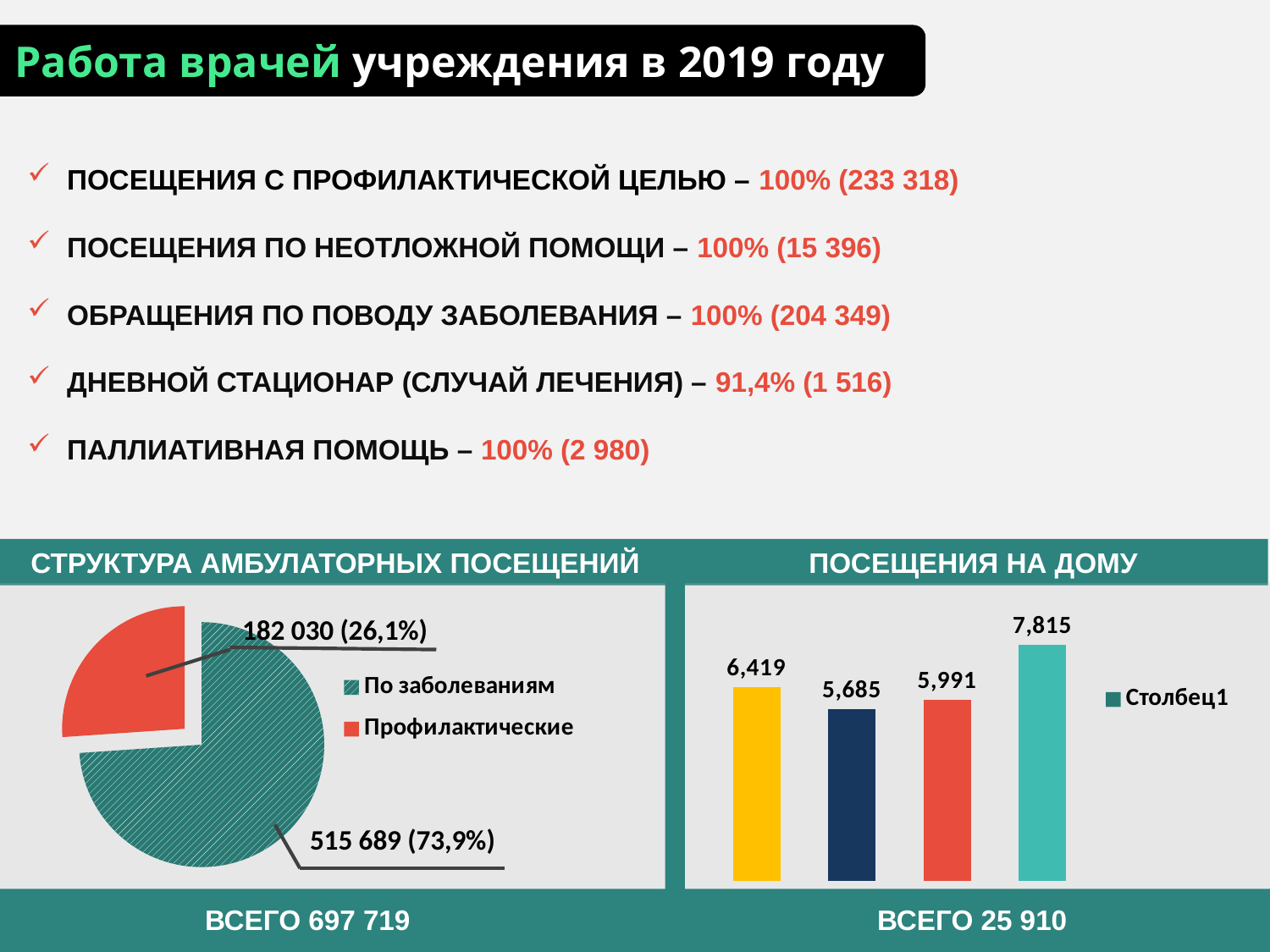
In the bar chart "ПОСЕЩЕНИЯ НА ДОМУ", what is the value of the shortest bar? 5,685 In the pie chart "СТРУКТУРА АМБУЛАТОРНЫХ ПОСЕЩЕНИЙ", what is the difference between the "По заболеваниям" and "Профилактические" values? 333 659 What legend entry is shown next to the bar chart "ПОСЕЩЕНИЯ НА ДОМУ"? Столбец1 In the pie chart "СТРУКТУРА АМБУЛАТОРНЫХ ПОСЕЩЕНИЙ", what share of the pie does the "Профилактические" slice have? 26,1% In the pie chart "СТРУКТУРА АМБУЛАТОРНЫХ ПОСЕЩЕНИЙ", which slice is larger: "По заболеваниям" or "Профилактические"? По заболеваниям What kind of chart is shown under the heading "СТРУКТУРА АМБУЛАТОРНЫХ ПОСЕЩЕНИЙ"? pie chart In the bar chart "ПОСЕЩЕНИЯ НА ДОМУ", what is the value of the first (yellow) bar on the left? 6,419 How many bars are in the bar chart "ПОСЕЩЕНИЯ НА ДОМУ"? 4 How many slices does the pie chart "СТРУКТУРА АМБУЛАТОРНЫХ ПОСЕЩЕНИЙ" have? 2 What kind of chart is shown under the heading "ПОСЕЩЕНИЯ НА ДОМУ"? bar chart In the pie chart "СТРУКТУРА АМБУЛАТОРНЫХ ПОСЕЩЕНИЙ", what value is labelled for the "По заболеваниям" slice? 515 689 (73,9%) In the bar chart "ПОСЕЩЕНИЯ НА ДОМУ", what is the value of the tallest bar? 7,815